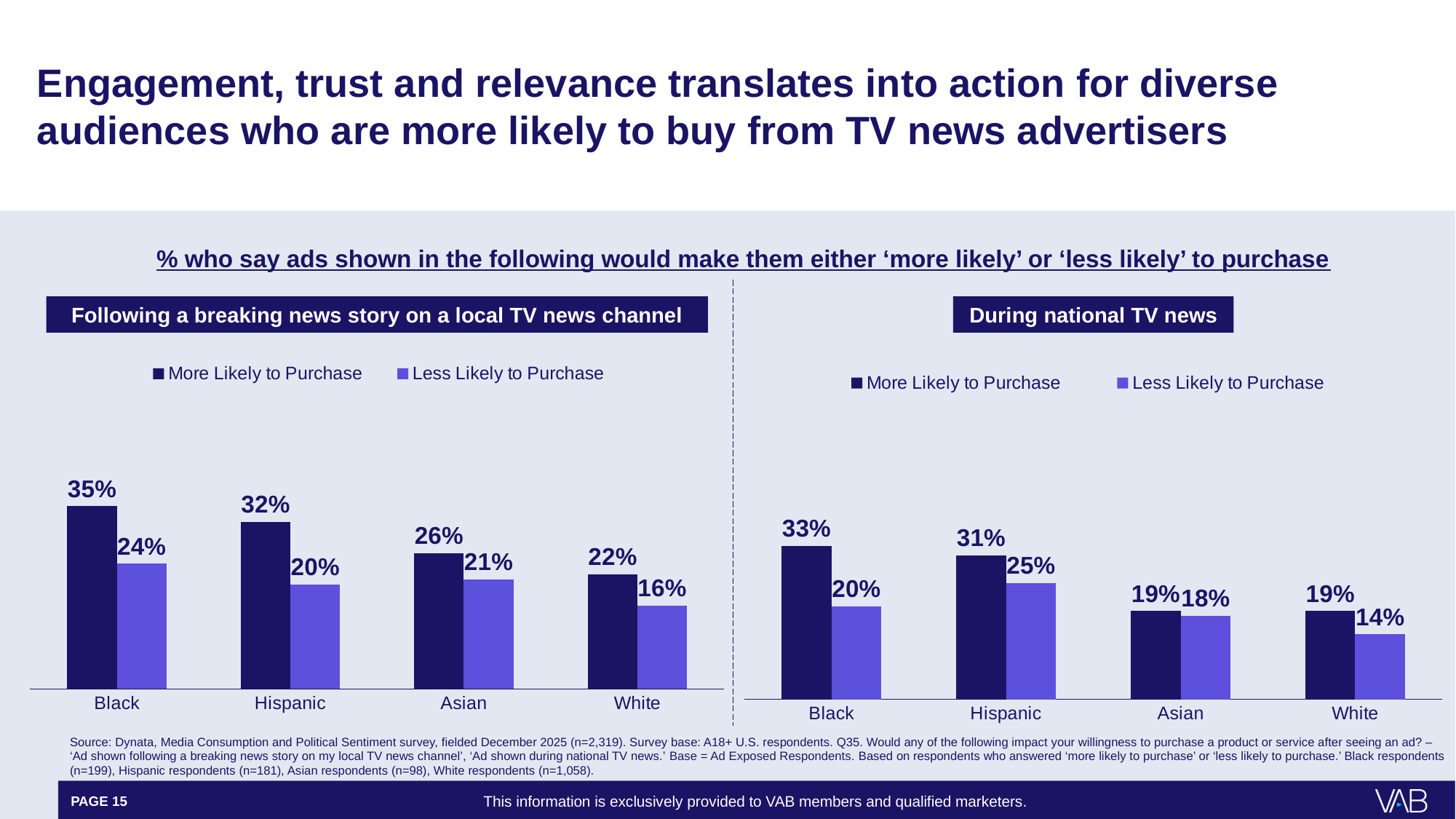
In the 'Following a breaking news story on a local TV news channel' chart, do the 'More Likely to Purchase' values rise or fall from Black to White along the x axis? Fall In the 'Following a breaking news story on a local TV news channel' chart, what is the 'More Likely to Purchase' value for Black respondents? 35% How many series does the legend of the 'During national TV news' chart list? 2 In the 'During national TV news' chart, what is the difference between the 'More Likely to Purchase' values for Black and White respondents? 14 percentage points In the 'Following a breaking news story on a local TV news channel' chart, what is the difference between the 'More Likely to Purchase' and 'Less Likely to Purchase' values for Hispanic respondents? 12 percentage points How many categories are shown on the x axis of the 'Following a breaking news story on a local TV news channel' chart? 4 What kind of chart is the 'During national TV news' chart? Bar chart In the 'During national TV news' chart, what is the 'Less Likely to Purchase' value for Hispanic respondents? 25% In the 'Following a breaking news story on a local TV news channel' chart, which category has the lowest 'More Likely to Purchase' value? White In the 'During national TV news' chart, which is larger for Asian respondents: 'More Likely to Purchase' or 'Less Likely to Purchase'? More Likely to Purchase In the 'During national TV news' chart, what is the 'Less Likely to Purchase' value for White respondents? 14% In the 'During national TV news' chart, which category has the highest 'More Likely to Purchase' value? Black